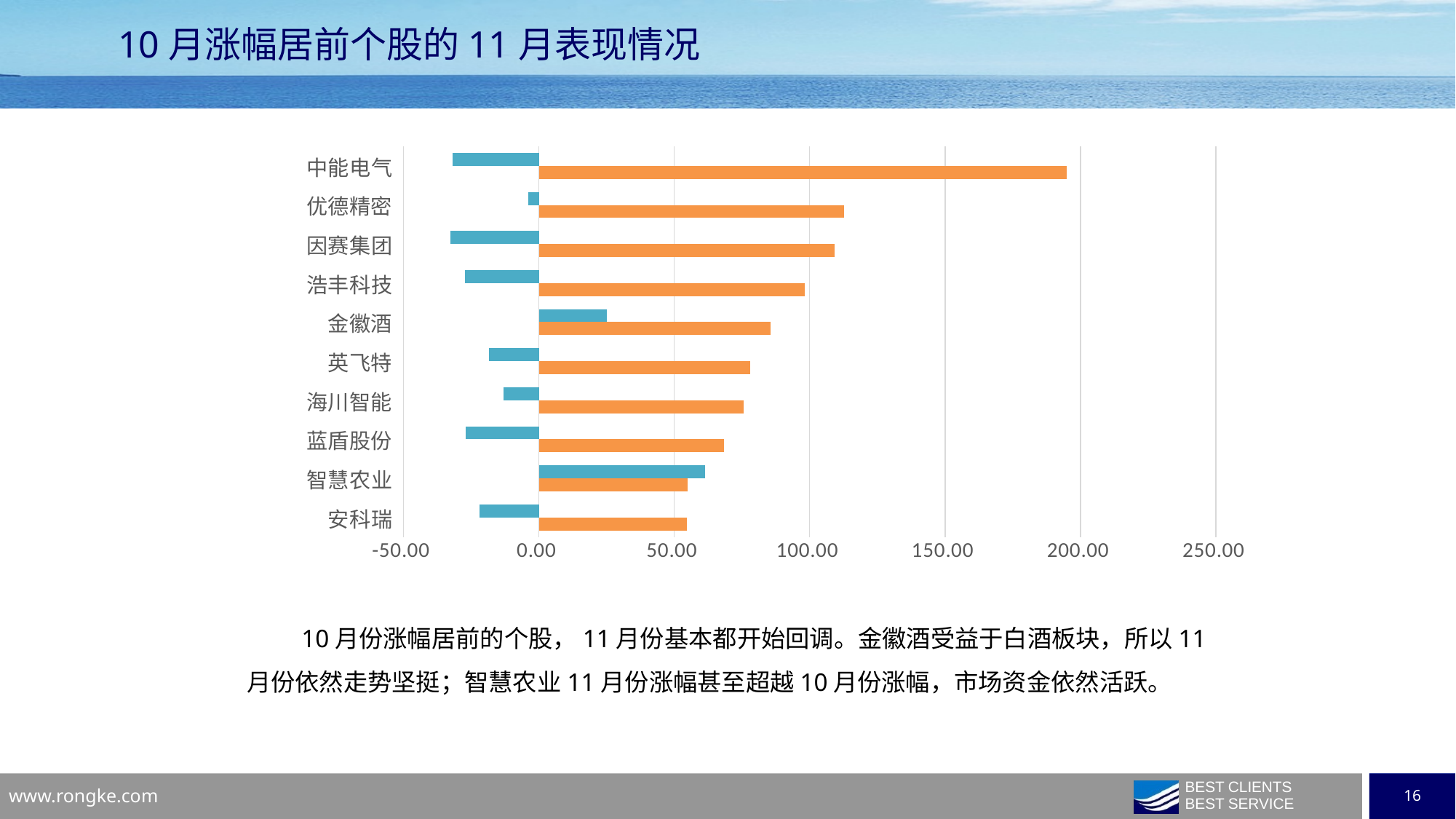
How many stocks (categories) are listed on the chart? 10 Is the blue bar value for 智慧农业 greater or less than 50.00? greater Which stock has the larger orange bar value, 中能电气 or 优德精密? 中能电气 What is the title of the slide containing the chart? 10 月涨幅居前个股的 11 月表现情况 How many stocks have a positive (greater than 0.00) blue bar value? 2 Which stock has the longest orange bar? 中能电气 Is the blue bar value for 金徽酒 greater or less than 0.00? greater What kind of chart is shown on the slide? bar chart Is the orange bar value for 优德精密 greater or less than 100.00? greater How many data series (bar colours) does the chart plot for each stock? 2 Which stock has the longest blue bar? 智慧农业